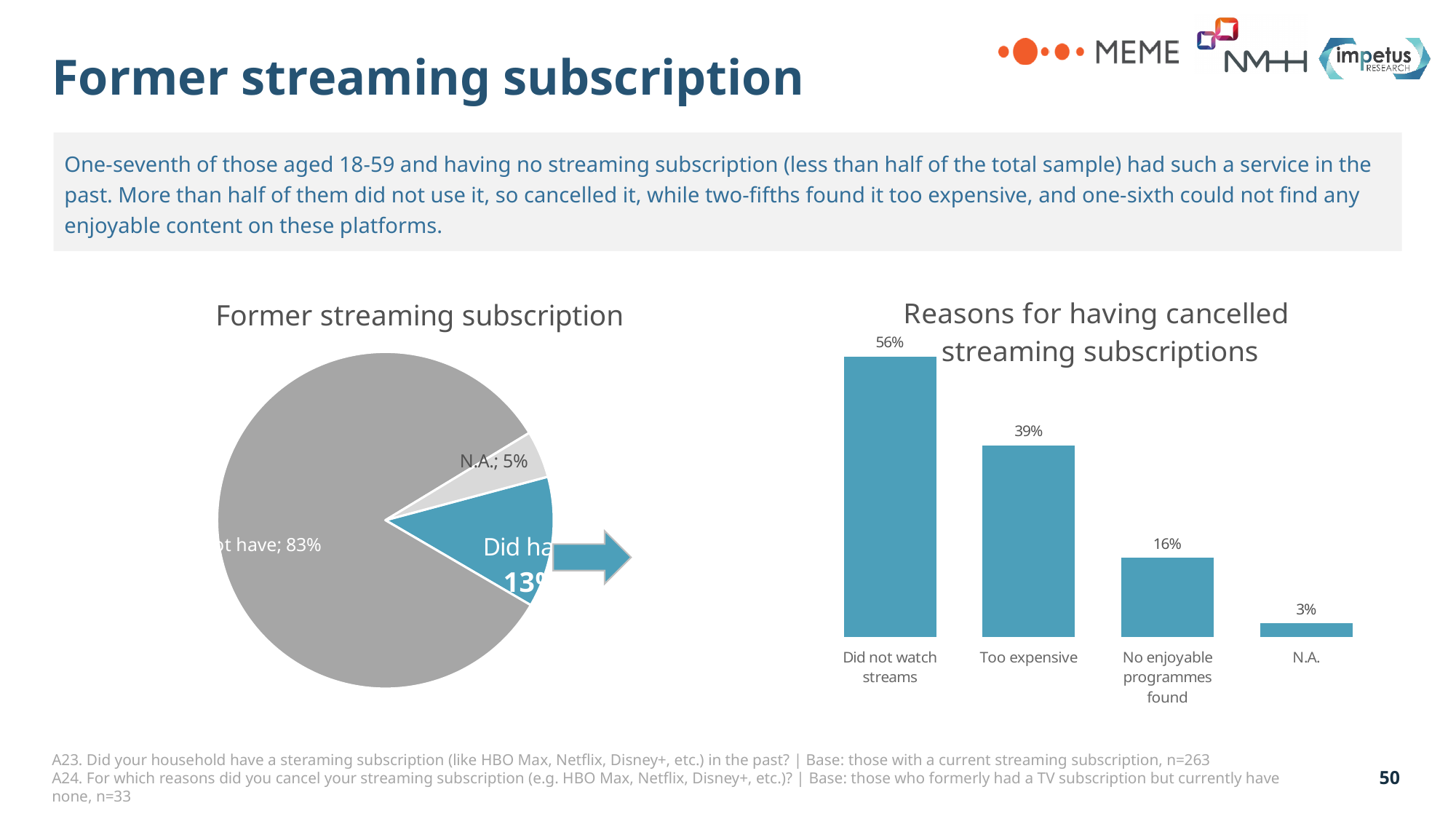
In the 'Former streaming subscription' pie chart, what share does the 'N.A.' slice have? 5% In the 'Reasons for having cancelled streaming subscriptions' chart, which is larger: 'Too expensive' or 'No enjoyable programmes found'? Too expensive In the 'Reasons for having cancelled streaming subscriptions' chart, what is the value for 'Too expensive'? 39% In the 'Reasons for having cancelled streaming subscriptions' chart, what is the value for 'N.A.'? 3% In the 'Reasons for having cancelled streaming subscriptions' chart, do the values rise or fall from left to right? Fall What kind of chart is the 'Reasons for having cancelled streaming subscriptions' chart? Bar chart How many categories are shown in the 'Reasons for having cancelled streaming subscriptions' chart? 4 In the 'Reasons for having cancelled streaming subscriptions' chart, which category has the lowest value? N.A. In the 'Reasons for having cancelled streaming subscriptions' chart, what is the value for 'Did not watch streams'? 56% In the 'Reasons for having cancelled streaming subscriptions' chart, what is the value for 'No enjoyable programmes found'? 16% In the 'Reasons for having cancelled streaming subscriptions' chart, which reason has the highest value? Did not watch streams In the 'Reasons for having cancelled streaming subscriptions' chart, what is the difference between 'Did not watch streams' and 'Too expensive'? 17 percentage points